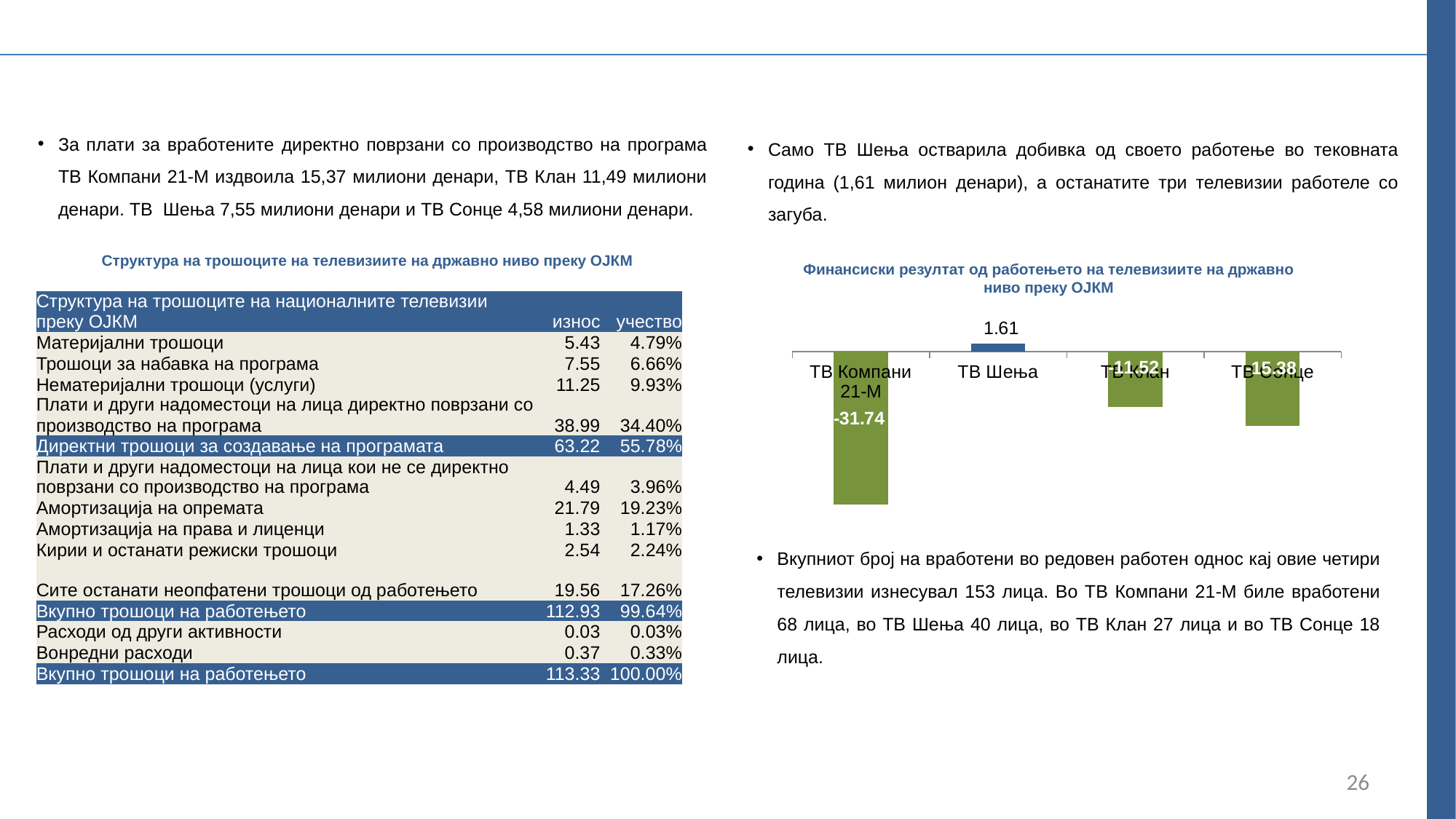
What is the value for ТВ Шења in the chart? 1.61 How many television stations are shown in the chart? 4 What is the title of the chart on the slide? Финансиски резултат од работењето на телевизиите на државно ниво преку ОЈКМ What type of chart is shown on the slide? bar chart Which has the larger value in the chart, ТВ Клан or ТВ Сонце? ТВ Клан Which television station has the lowest value in the chart? ТВ Компани 21-М What is the value for ТВ Сонце in the chart? -15.38 What is the difference between the values for ТВ Сонце and ТВ Клан in the chart? 3.86 Which television station has the highest value in the chart? ТВ Шења What is the value for ТВ Компани 21-М in the chart? -31.74 Which television station is the only one with a positive value in the chart? ТВ Шења What is the value for ТВ Клан in the chart? -11.52